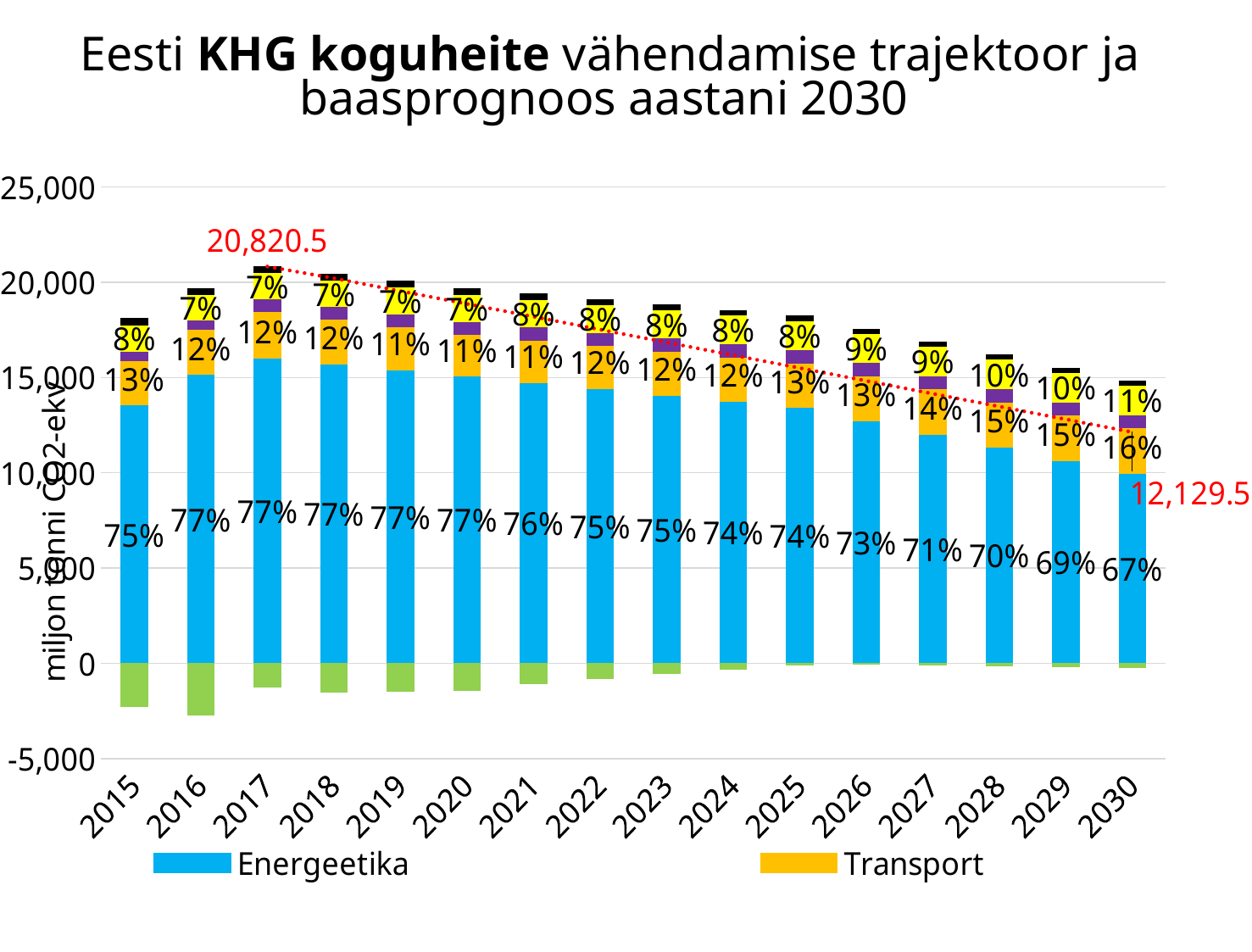
What type of chart is shown on the slide? stacked bar chart How many years are shown on the x axis? 16 Which year has the highest Transport share? 2030 What is the Transport share for 2030? 16% What is the difference between the two values labelled on the red dotted trajectory line, 20,820.5 and 12,129.5? 8,691 Is the Transport share larger in 2015 or in 2019? 2015 What is the difference between the Energeetika share in 2016 and in 2030? 10% What is the Energeetika share for 2027? 71% How many series does the legend list? 2 What value is labelled at the start of the red dotted trajectory line? 20,820.5 Which year has the lowest Energeetika share? 2030 What is the Energeetika share for 2015? 75%